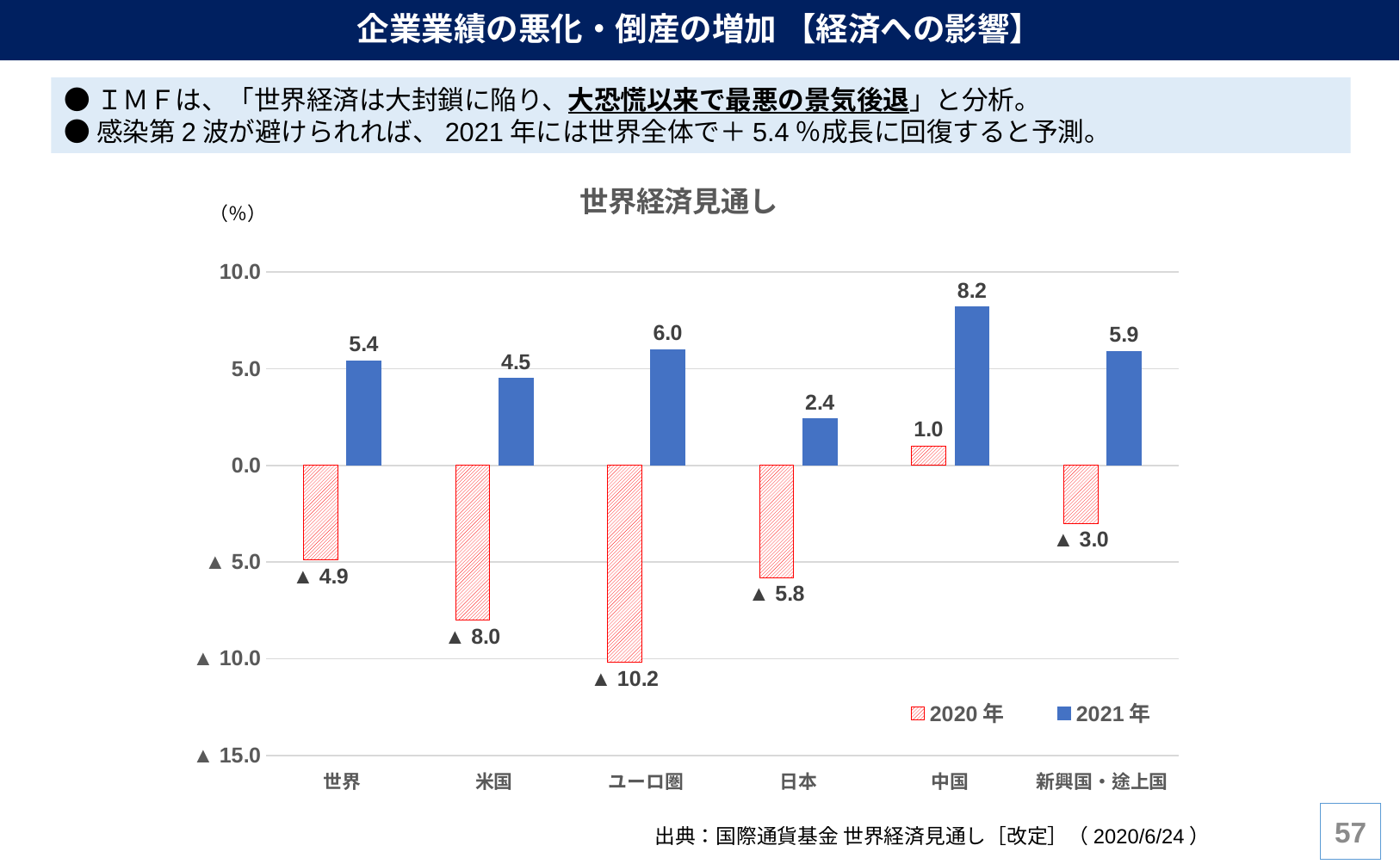
Which category is the only one with a positive 2020年 value in the 世界経済見通し chart? 中国 Which category has the lowest 2021年 value in the 世界経済見通し chart? 日本 What is the 2020年 value for ユーロ圏 in the 世界経済見通し chart? ▲ 10.2 What is the 2020年 value for 日本 in the 世界経済見通し chart? ▲ 5.8 Which category has the highest 2021年 value in the 世界経済見通し chart? 中国 What is the difference between the 2021年 values for 中国 and 日本 in the 世界経済見通し chart? 5.8 Which category has the lowest 2020年 value in the 世界経済見通し chart? ユーロ圏 How many series does the legend of the 世界経済見通し chart list? 2 Which is larger in the 世界経済見通し chart: the 2021年 value for ユーロ圏 or the 2021年 value for 米国? ユーロ圏 What kind of chart is the 世界経済見通し chart? bar chart What is the 2021年 value for 中国 in the 世界経済見通し chart? 8.2 How many categories are shown on the x axis of the 世界経済見通し chart? 6